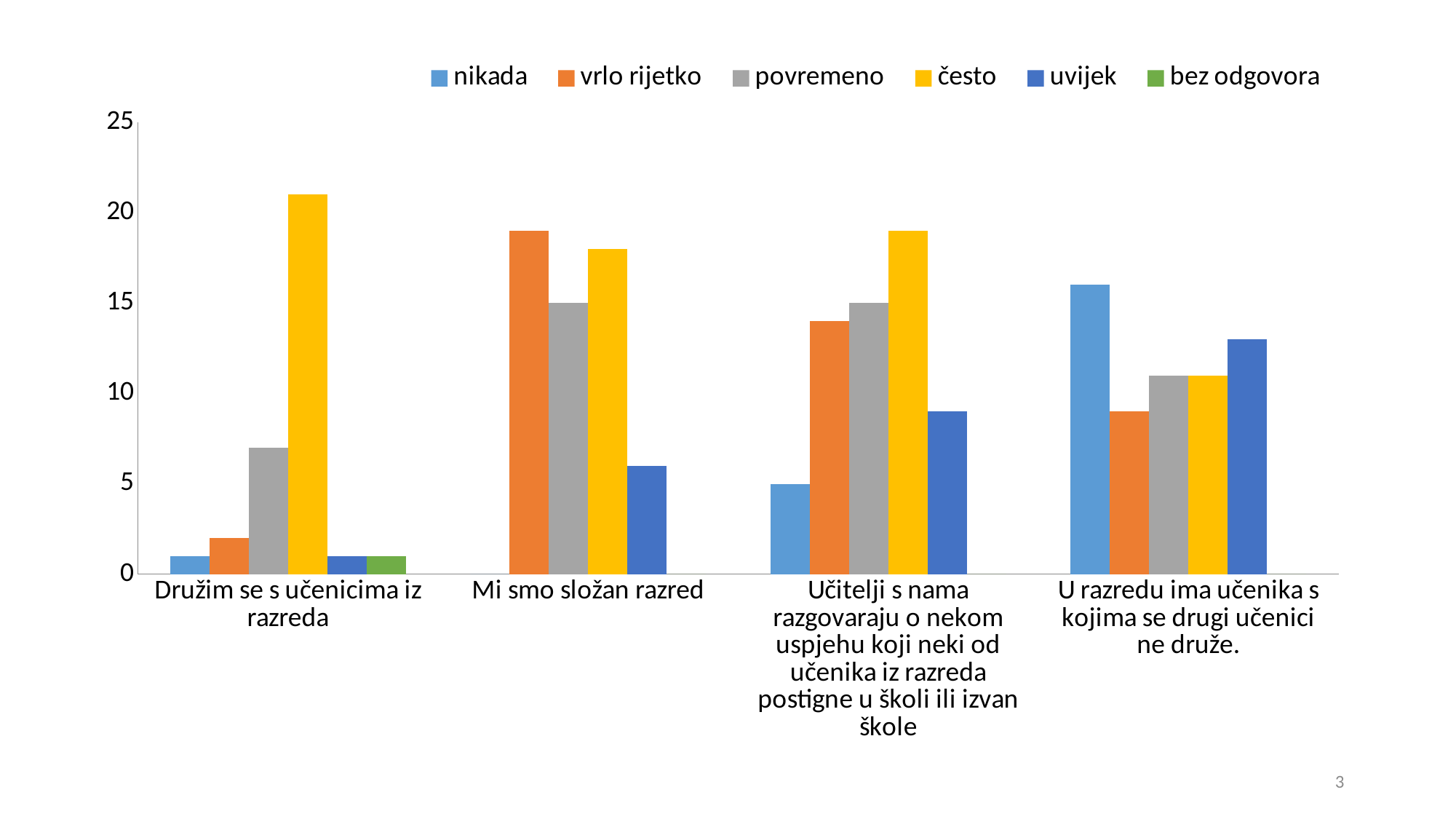
What kind of chart is shown on the slide? bar chart Which category is the only one with a visible 'bez odgovora' bar? Družim se s učenicima iz razreda Is the value for 'vrlo rijetko' in the category 'Mi smo složan razred' greater or less than 15? greater In the category 'Mi smo složan razred', which is larger: 'vrlo rijetko' or 'uvijek'? vrlo rijetko For the category 'Družim se s učenicima iz razreda', which series has the highest bar? često For the category 'U razredu ima učenika s kojima se drugi učenici ne druže.', which series has the highest bar? nikada How many series does the legend list? 6 Is the value for 'nikada' in the category 'Učitelji s nama razgovaraju o nekom uspjehu koji neki od učenika iz razreda postigne u školi ili izvan škole' greater or less than 10? less Is the value for 'uvijek' in the category 'Mi smo složan razred' greater or less than 10? less How many categories are shown along the x axis? 4 In the category 'Učitelji s nama razgovaraju o nekom uspjehu koji neki od učenika iz razreda postigne u školi ili izvan škole', which is larger: 'često' or 'nikada'? često